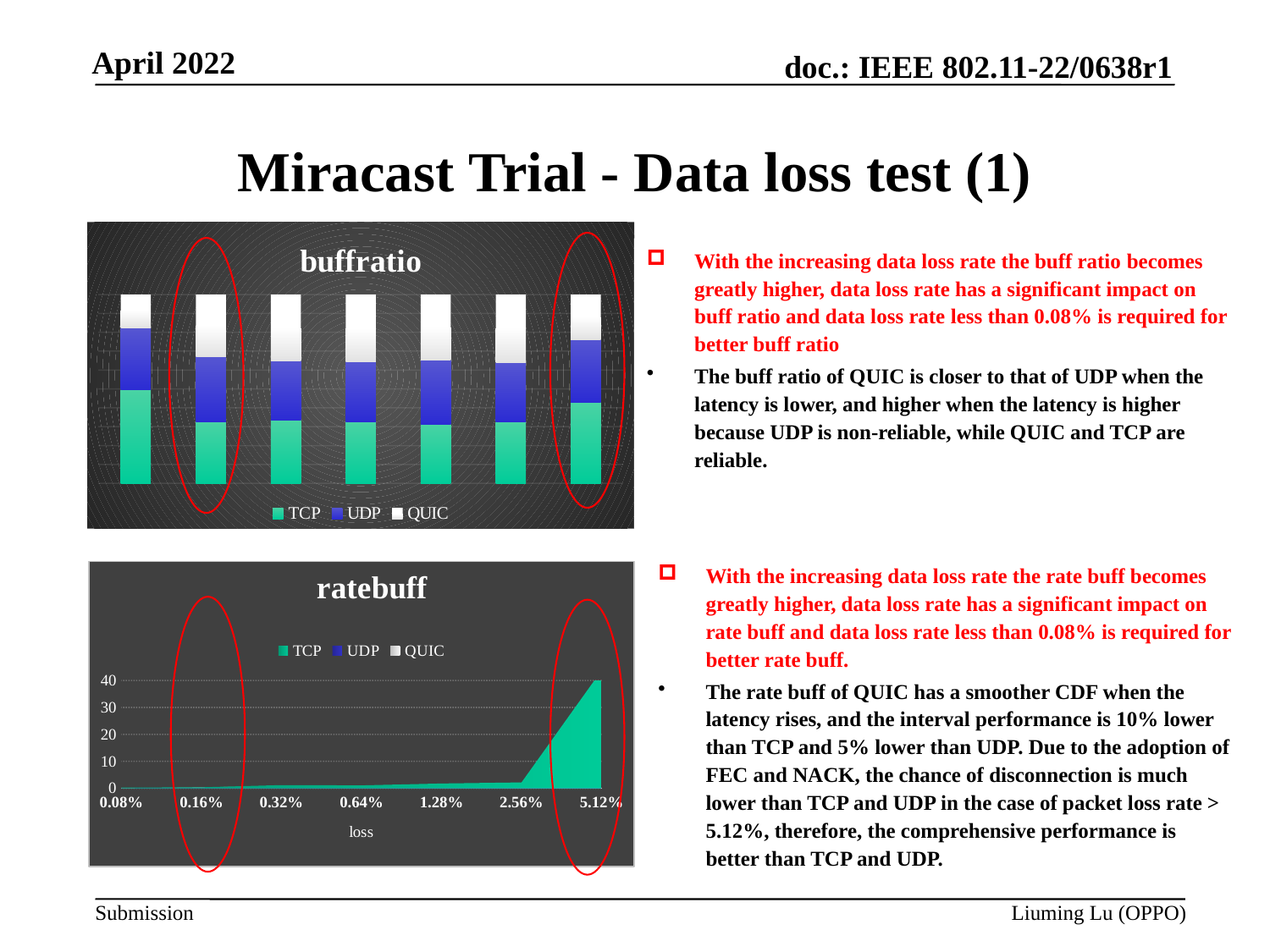
In the "ratebuff" chart, do the values rise or fall as loss increases from 2.56% to 5.12%? rise How many loss categories are shown on the x axis of the "ratebuff" chart? 7 What kind of chart is the "ratebuff" chart? area chart What kind of chart is the "buffratio" chart? stacked bar chart How many series does the legend of the "buffratio" chart list? 3 Which series is shown at the bottom of each stacked bar in the "buffratio" chart? TCP In the "ratebuff" chart, is the value at 0.08% loss greater or less than 10? less How many bars are plotted in the "buffratio" chart? 7 In the "ratebuff" chart, is the value at 5.12% loss greater or less than 30? greater How many series does the legend of the "ratebuff" chart list? 3 In the "ratebuff" chart, at which loss value does the plotted area reach its highest point? 5.12% What is the x-axis title of the "ratebuff" chart? loss